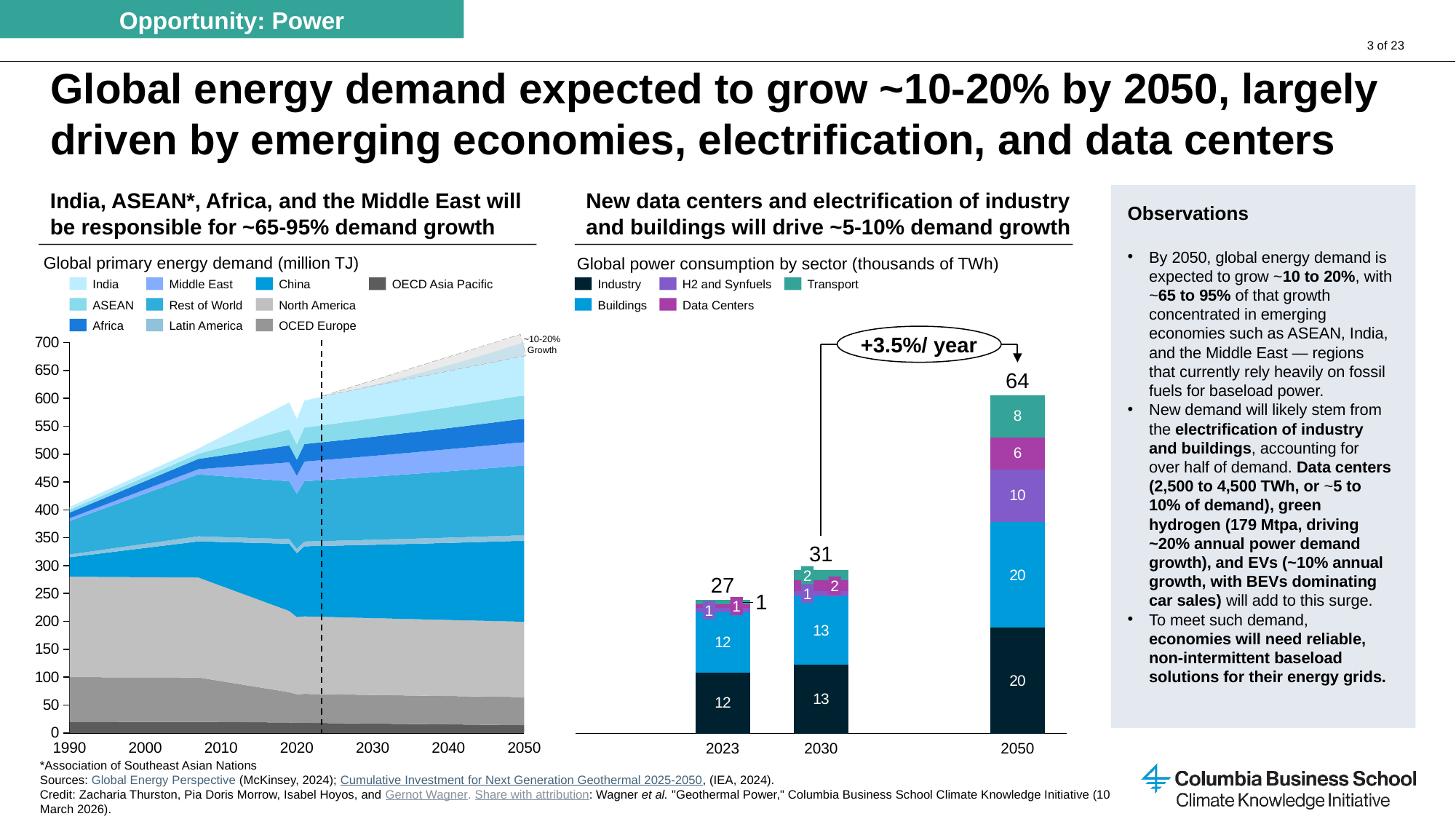
In the 'Global power consumption by sector' chart, what is the total for 2050? 64 In the 'Global power consumption by sector' chart, which is larger in 2050: H2 and Synfuels or Data Centers? H2 and Synfuels What kind of chart is the 'Global power consumption by sector' chart on the right? bar chart How many series does the legend of the 'Global power consumption by sector' chart list? 5 In the 'Global power consumption by sector' chart, what is the difference between the 2050 total and the 2023 total? 37 In the 'Global power consumption by sector' chart, what is the value for Transport in 2050? 8 In the 'Global power consumption by sector' chart, what is the value for Industry in 2050? 20 How many series does the legend of the 'Global primary energy demand' chart list? 10 What annual growth rate is annotated above the bars in the 'Global power consumption by sector' chart? +3.5%/ year In the 'Global power consumption by sector' chart, how many years are shown as bars? 3 In the 'Global power consumption by sector' chart, what is the value for Data Centers in 2050? 6 In the 'Global power consumption by sector' chart, what is the value for Buildings in 2030? 13